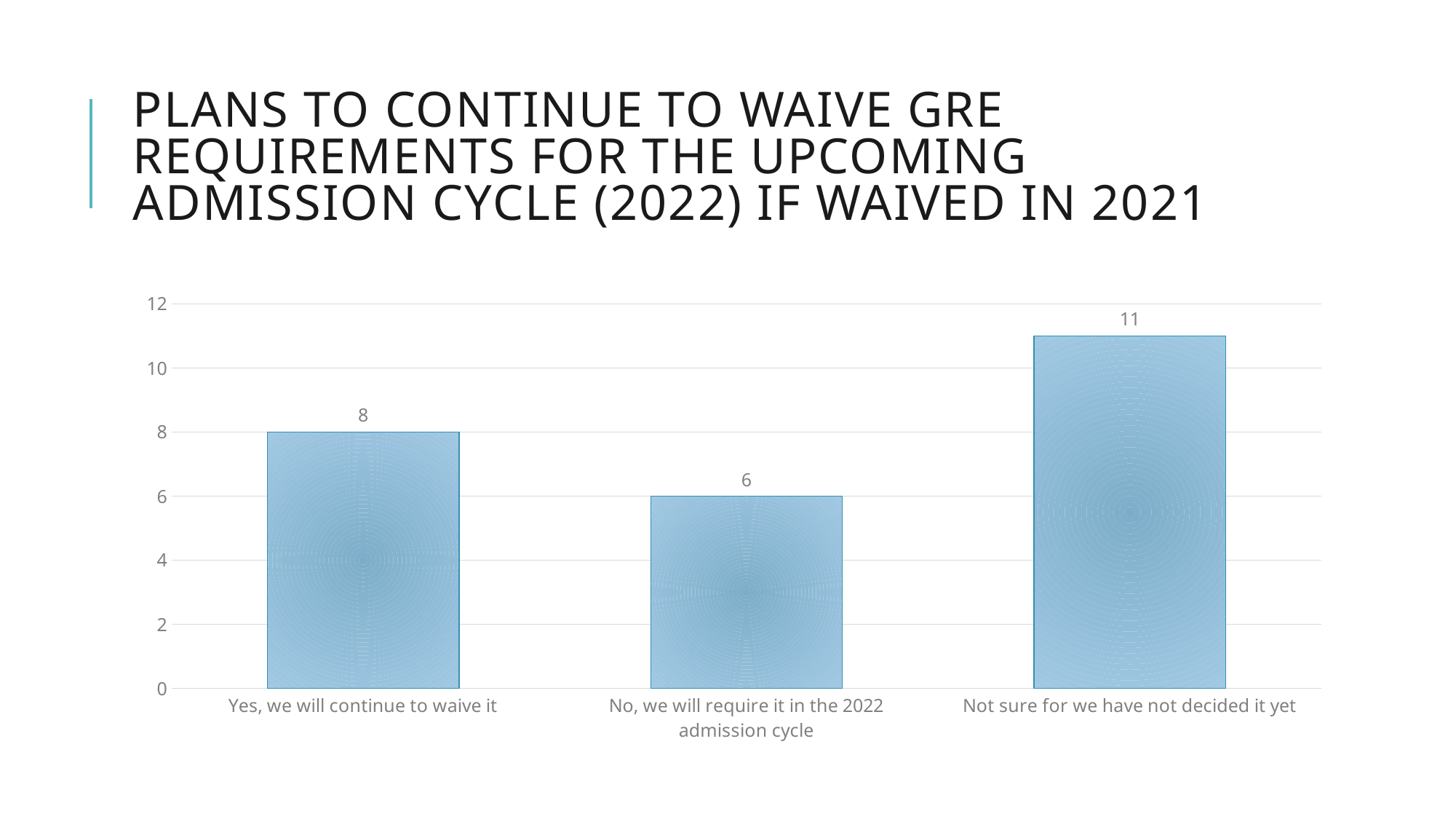
What kind of chart is shown on the slide? bar chart What is the value for "No, we will require it in the 2022 admission cycle"? 6 Which category has the lowest value? No, we will require it in the 2022 admission cycle What is the difference between the values for "Yes, we will continue to waive it" and "No, we will require it in the 2022 admission cycle"? 2 What is the title of the slide? Plans to continue to waive GRE requirements for the upcoming admission cycle (2022) if waived in 2021 Which is larger: the value for "Yes, we will continue to waive it" or the value for "No, we will require it in the 2022 admission cycle"? Yes, we will continue to waive it Which category has the highest value? Not sure for we have not decided it yet How many categories are shown in the chart? 3 What is the difference between the values for "Not sure for we have not decided it yet" and "Yes, we will continue to waive it"? 3 Is the value for "Not sure for we have not decided it yet" greater or less than 10? greater What is the value for "Not sure for we have not decided it yet"? 11 What is the value for "Yes, we will continue to waive it"? 8